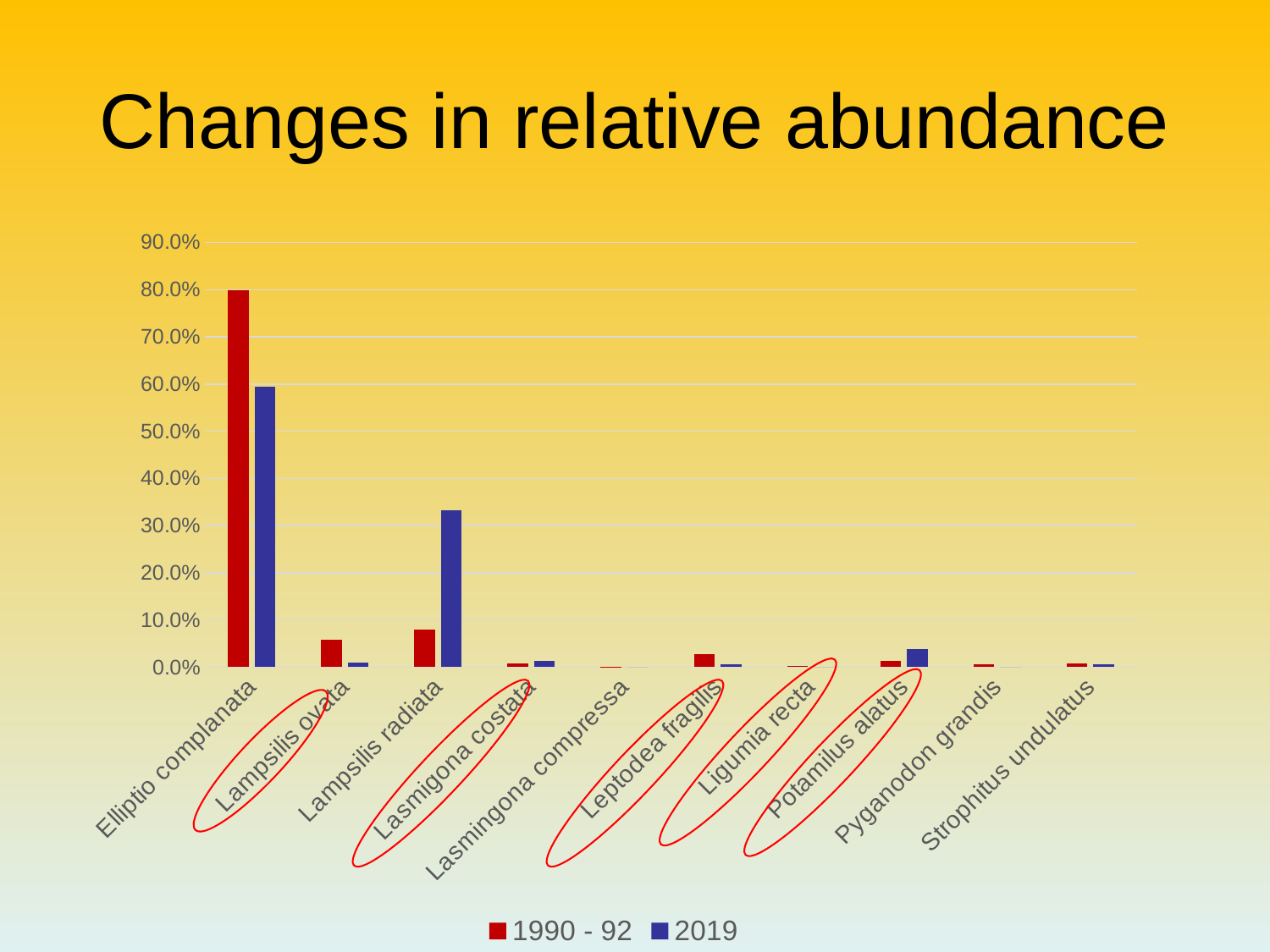
Which species has the highest relative abundance in the 2019 series? Elliptio complanata For Elliptio complanata, which series has the larger value, 1990 - 92 or 2019? 1990 - 92 What kind of chart is shown on the slide? bar chart Is the 2019 value for Elliptio complanata greater or less than 50.0%? greater Is the 1990 - 92 value for Lampsilis ovata greater or less than 10.0%? less Is the 2019 value for Lampsilis radiata greater or less than 30.0%? greater How many species categories are shown on the x axis? 10 Which species has the highest relative abundance in the 1990 - 92 series? Elliptio complanata What is the title of the slide containing the chart? Changes in relative abundance For Lampsilis radiata, which series has the larger value, 1990 - 92 or 2019? 2019 How many series does the legend list? 2